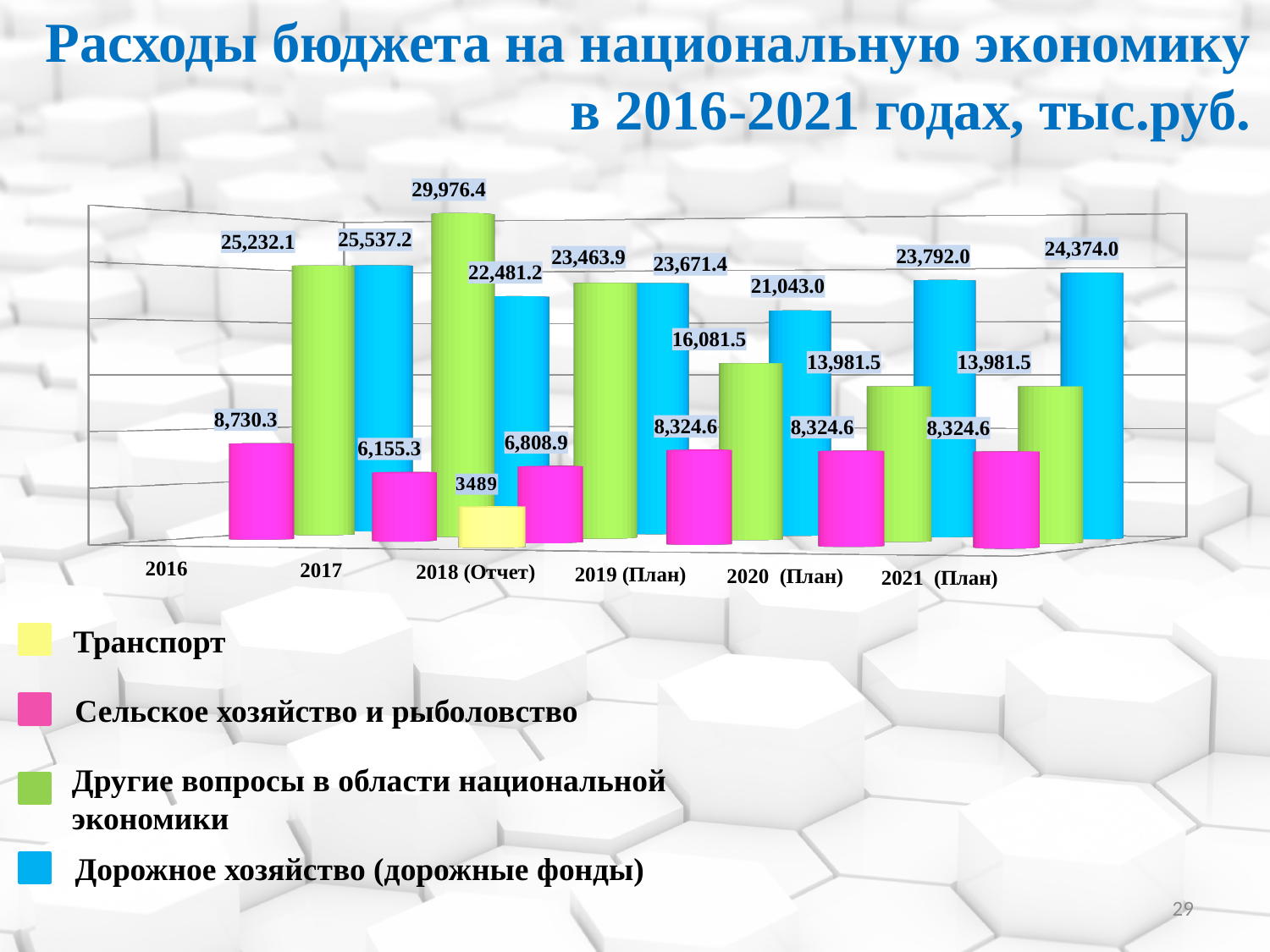
Does the value for Дорожное хозяйство (дорожные фонды) rise or fall from 2019 (План) to 2021 (План)? Rise How many year categories are shown on the x axis of the chart? 6 In 2021 (План), what is the difference between Дорожное хозяйство (дорожные фонды) and Другие вопросы в области национальной экономики? 10,392.5 What is the value for Сельское хозяйство и рыболовство in 2016? 8,730.3 What is the value shown for Транспорт? 3489 What type of chart is shown on the slide? Bar chart In 2017, which is larger: Другие вопросы в области национальной экономики or Дорожное хозяйство (дорожные фонды)? Другие вопросы в области национальной экономики What is the value for Другие вопросы в области национальной экономики in 2018 (Отчет)? 23,463.9 What is the value for Дорожное хозяйство (дорожные фонды) in 2021 (План)? 24,374.0 How many series does the legend list? 4 What colour represents Транспорт in the legend? Yellow What is the highest value labelled on the chart? 29,976.4